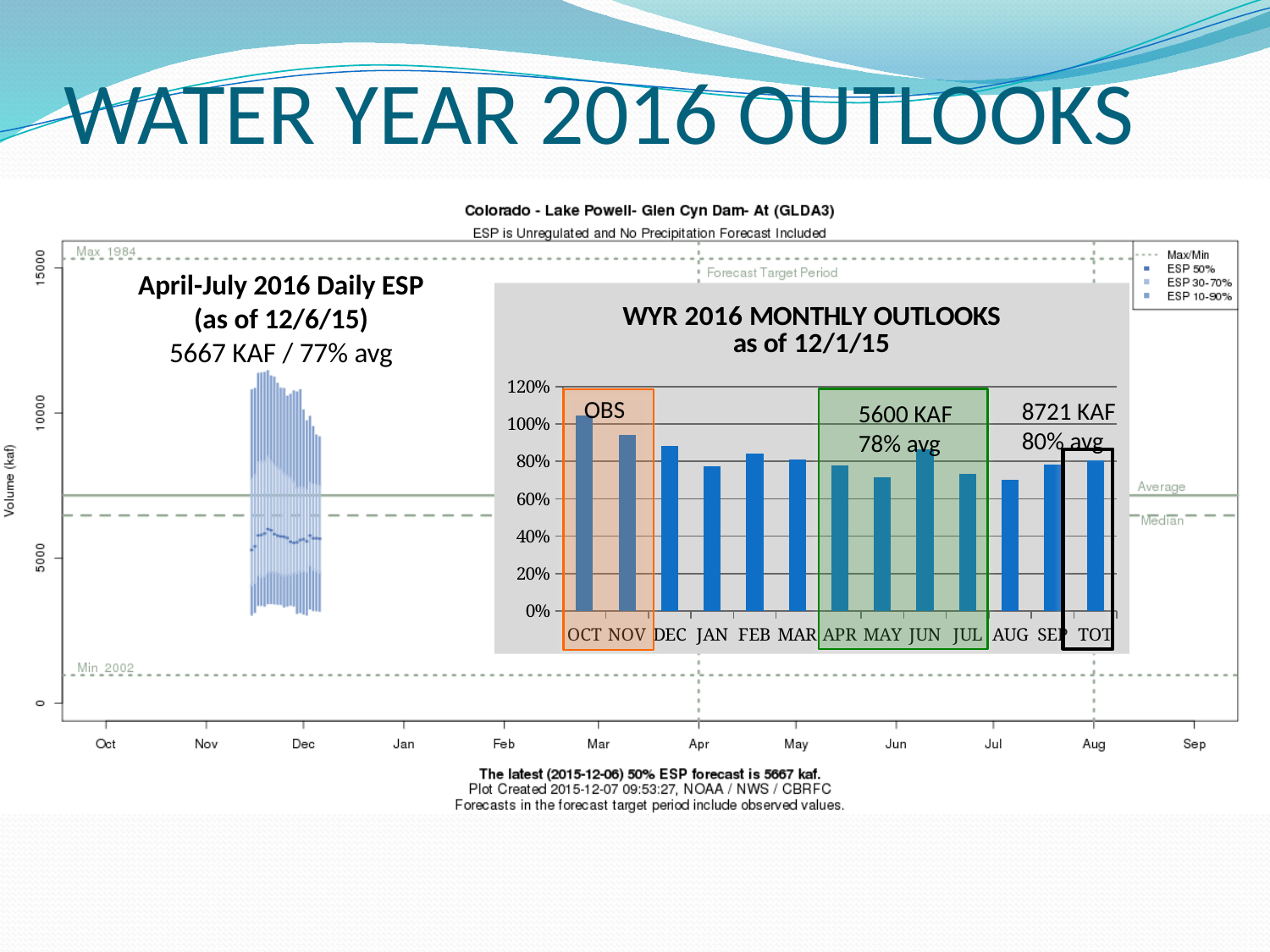
In the WYR 2016 MONTHLY OUTLOOKS chart, what volume in KAF is annotated for the TOT bar? 8721 KAF In the WYR 2016 MONTHLY OUTLOOKS chart, what percent of average is annotated for the APR-JUL period? 78% avg In the background Colorado - Lake Powell- Glen Cyn Dam- At (GLDA3) chart, how many entries does the legend list? 4 In the WYR 2016 MONTHLY OUTLOOKS chart, how many bars are plotted along the x axis? 13 In the WYR 2016 MONTHLY OUTLOOKS chart, is the value for OCT greater or less than 100%? greater In the WYR 2016 MONTHLY OUTLOOKS chart, which month has the highest bar? OCT In the WYR 2016 MONTHLY OUTLOOKS chart, is the value for JAN greater or less than 80%? less In the WYR 2016 MONTHLY OUTLOOKS chart, which is larger, the value for OCT or the value for NOV? OCT In the WYR 2016 MONTHLY OUTLOOKS chart, is the value for AUG greater or less than 80%? less In the WYR 2016 MONTHLY OUTLOOKS chart, what kind of chart is used to show the monthly values? bar chart In the WYR 2016 MONTHLY OUTLOOKS chart, which is larger, the value for JUN or the value for MAY? JUN